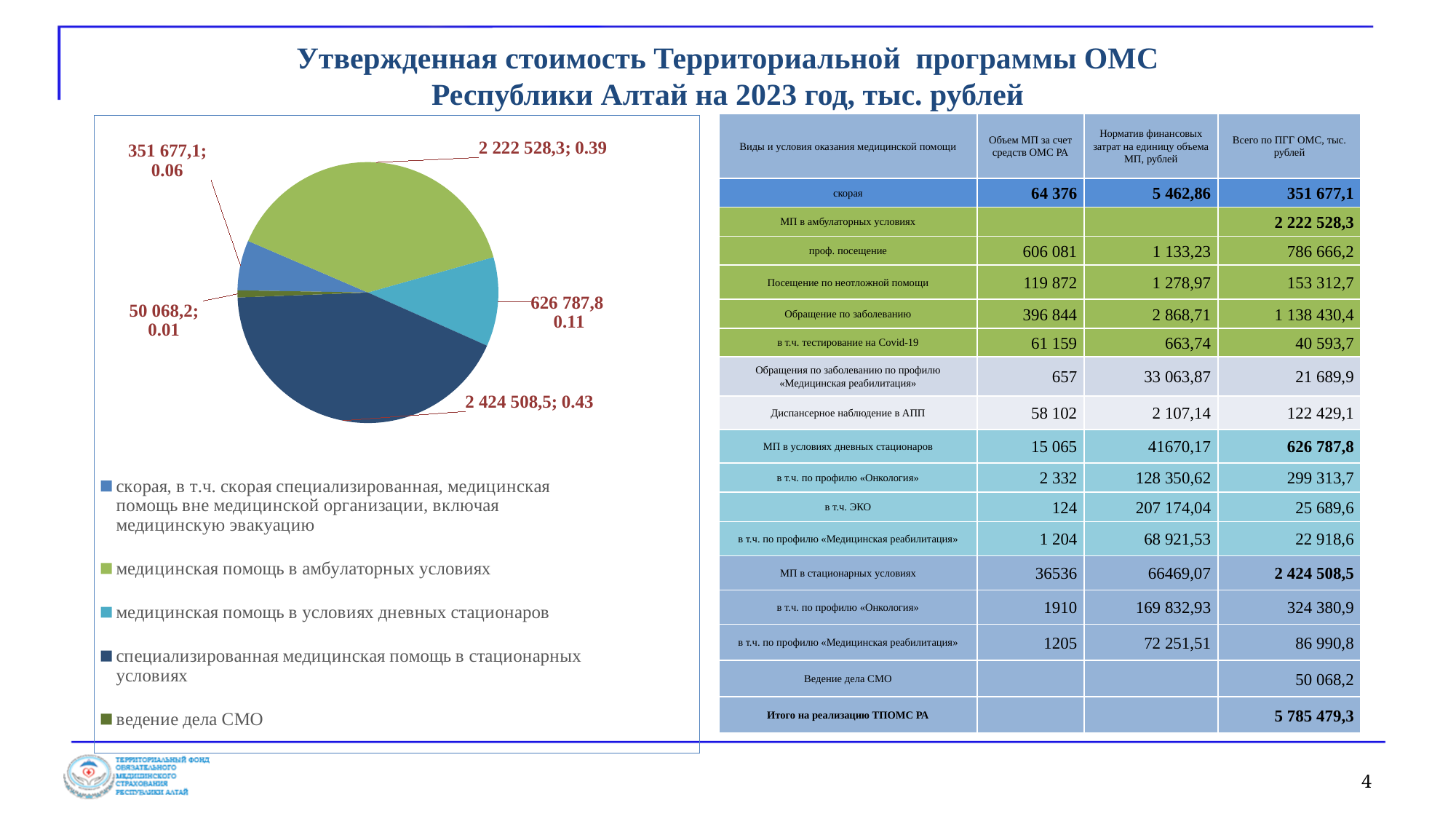
Which is larger in the pie chart: the value for 'медицинская помощь в амбулаторных условиях' or the value for 'медицинская помощь в условиях дневных стационаров'? медицинская помощь в амбулаторных условиях What value is shown for the slice 'ведение дела СМО' in the pie chart? 50 068,2 What kind of chart is shown on the left of the slide? Pie chart Which slice of the pie chart is the largest? специализированная медицинская помощь в стационарных условиях What share of the pie does the slice for 'скорая' (emergency care) represent, as labelled on the chart? 0.06 What is the difference between the pie chart values for 'специализированная медицинская помощь в стационарных условиях' (2 424 508,5) and 'медицинская помощь в амбулаторных условиях' (2 222 528,3)? 201 980,2 What value is shown for the slice 'медицинская помощь в амбулаторных условиях' in the pie chart? 2 222 528,3 What share of the pie does the slice 'специализированная медицинская помощь в стационарных условиях' represent, as labelled on the chart? 0.43 What colour is the slice for 'медицинская помощь в амбулаторных условиях' in the pie chart? Light green Which slice of the pie chart is the smallest? ведение дела СМО How many slices does the pie chart have? 5 What value is shown for the slice 'медицинская помощь в условиях дневных стационаров' in the pie chart? 626 787,8